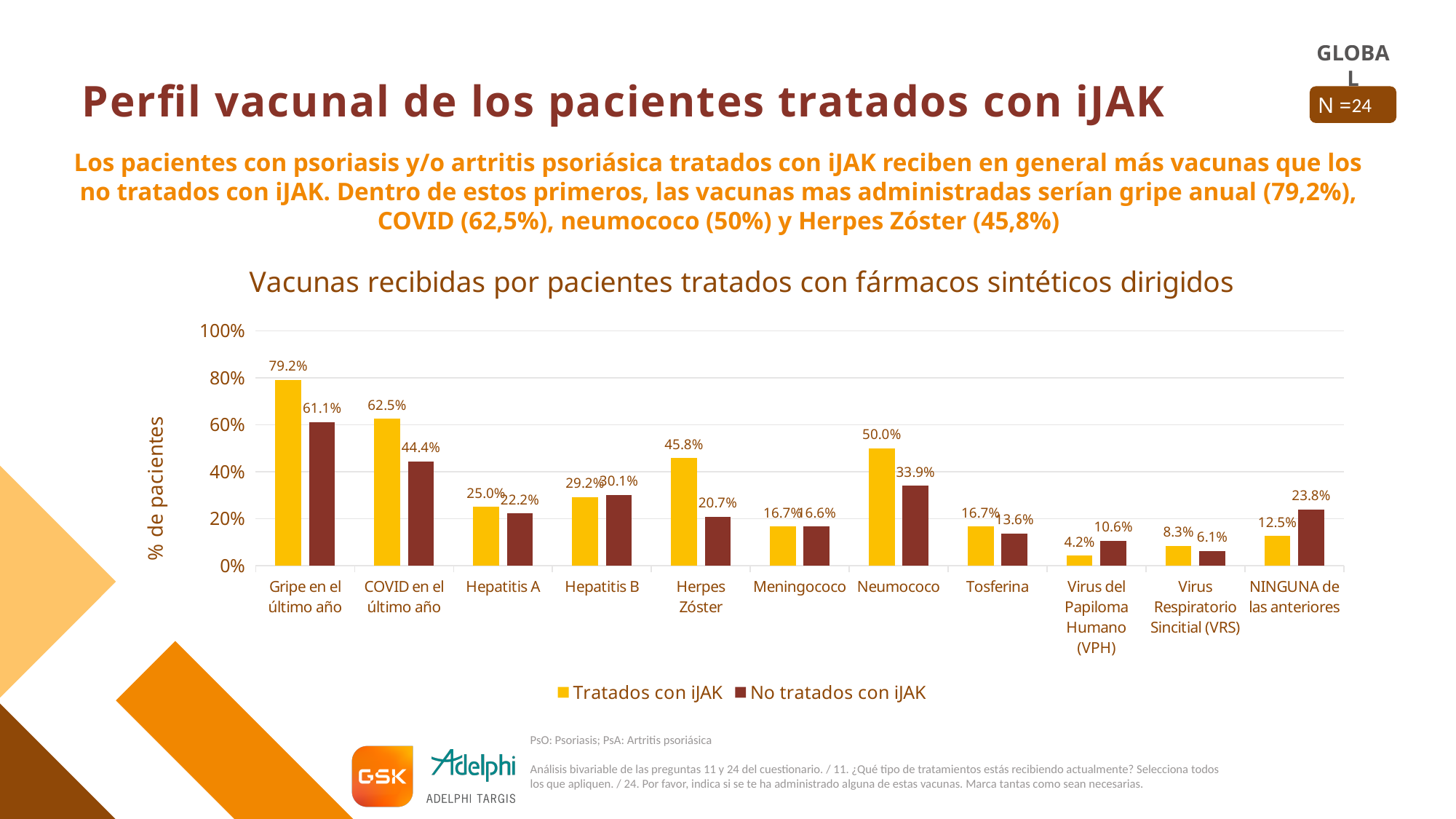
What is the title of the chart? Vacunas recibidas por pacientes tratados con fármacos sintéticos dirigidos What is the difference between Tratados con iJAK and No tratados con iJAK for Neumococo? 16.1% What percentage of patients treated with iJAK (Tratados con iJAK) received the Gripe en el último año vaccine? 79.2% How many series does the legend list? 2 How many vaccine categories are shown on the x axis? 11 What kind of chart is shown on the slide? Bar chart What is the value for No tratados con iJAK for Herpes Zóster? 20.7% What is the value for Tratados con iJAK for Virus del Papiloma Humano (VPH)? 4.2% Which category has the lowest value for No tratados con iJAK? Virus Respiratorio Sincitial (VRS) For NINGUNA de las anteriores, which series has the larger value: Tratados con iJAK or No tratados con iJAK? No tratados con iJAK Which vaccine category has the highest value for Tratados con iJAK? Gripe en el último año Is the value for Tratados con iJAK for COVID en el último año greater or less than 60%? greater